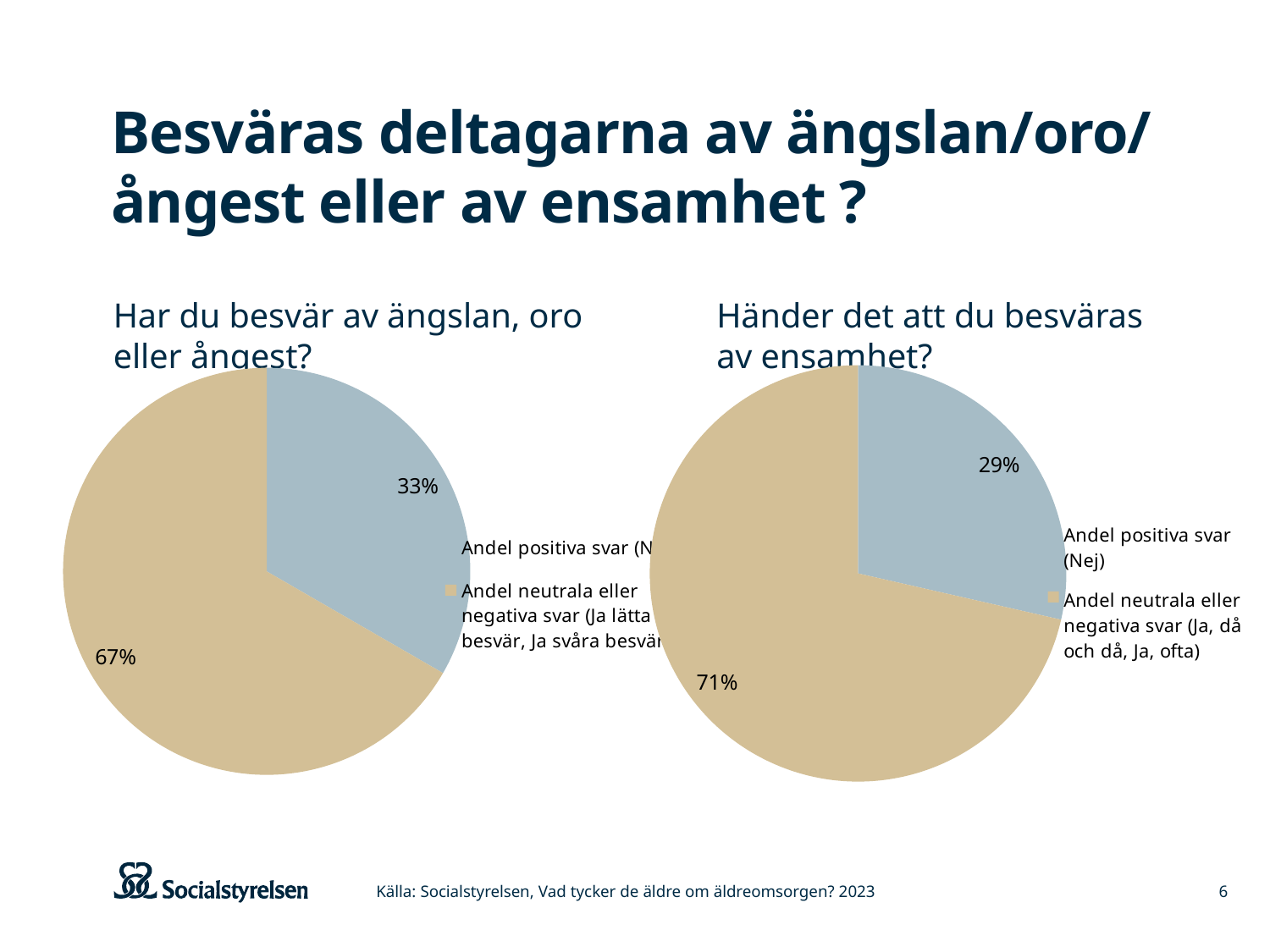
In the left chart (Har du besvär av ängslan, oro eller ångest?), what share of answers are positive (Nej)? 33% What kind of chart is used on this slide? Pie chart In the left chart (Har du besvär av ängslan, oro eller ångest?), which slice is the largest? Andel neutrala eller negativa svar In the left chart (Har du besvär av ängslan, oro eller ångest?), what is the difference between the neutral/negative share and the positive share? 34 percentage points In the right chart (Händer det att du besväras av ensamhet?), what colour is the slice for Andel positiva svar (Nej)? Blue In the right chart (Händer det att du besväras av ensamhet?), what share of answers are positive (Nej)? 29% In the left chart (Har du besvär av ängslan, oro eller ångest?), what share of answers are neutral or negative? 67% In the right chart (Händer det att du besväras av ensamhet?), what share of answers are neutral or negative (Ja, då och då, Ja, ofta)? 71% How many slices does each pie chart on the slide have? 2 In the right chart (Händer det att du besväras av ensamhet?), which slice is the smallest? Andel positiva svar (Nej) Which chart has the larger share of positive (Nej) answers, the left chart on ängslan/oro/ångest or the right chart on ensamhet? The left chart (33%) In the right chart (Händer det att du besväras av ensamhet?), what is the difference between the neutral/negative share and the positive share? 42 percentage points